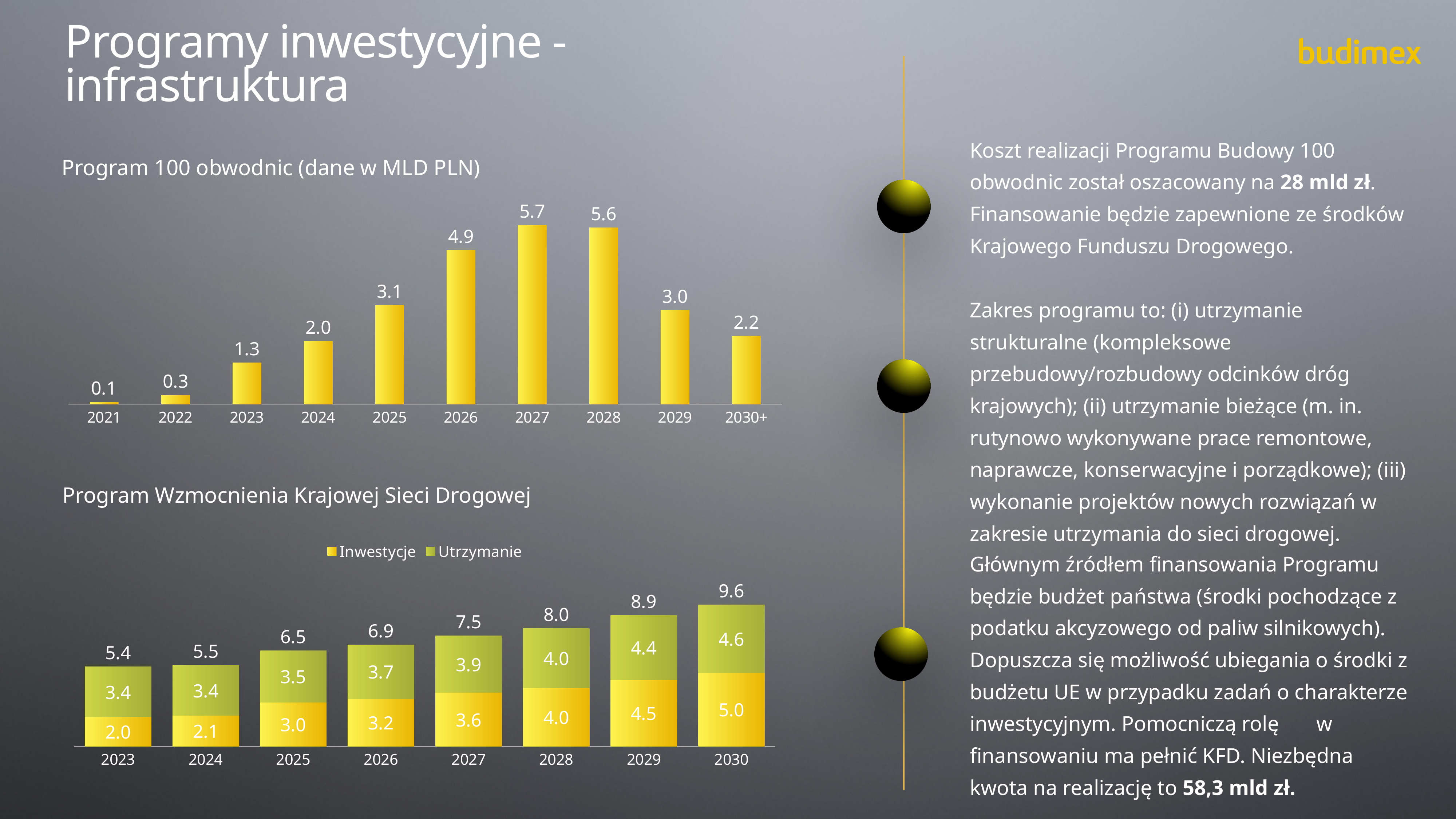
In the 'Program 100 obwodnic' chart, which year has the highest value? 2027 In the 'Program Wzmocnienia Krajowej Sieci Drogowej' chart, how many series does the legend list? 2 In the 'Program 100 obwodnic' chart, what is the value for 2027? 5.7 In the 'Program 100 obwodnic' chart, which year has the lowest value? 2021 In the 'Program Wzmocnienia Krajowej Sieci Drogowej' chart, what is the total of the stacked bar for 2029? 8.9 In the 'Program 100 obwodnic' chart, what is the difference between the values for 2026 and 2025? 1.8 In the 'Program Wzmocnienia Krajowej Sieci Drogowej' chart, what is the Utrzymanie value for 2027? 3.9 In the 'Program 100 obwodnic' chart, do the values rise or fall from 2021 to 2027? rise In the 'Program 100 obwodnic' chart, how many years are shown on the x axis? 10 What kind of chart is the 'Program Wzmocnienia Krajowej Sieci Drogowej' chart? stacked bar chart In the 'Program Wzmocnienia Krajowej Sieci Drogowej' chart, what is the Inwestycje value for 2030? 5.0 In the 'Program Wzmocnienia Krajowej Sieci Drogowej' chart, which is larger for 2023: Inwestycje or Utrzymanie? Utrzymanie